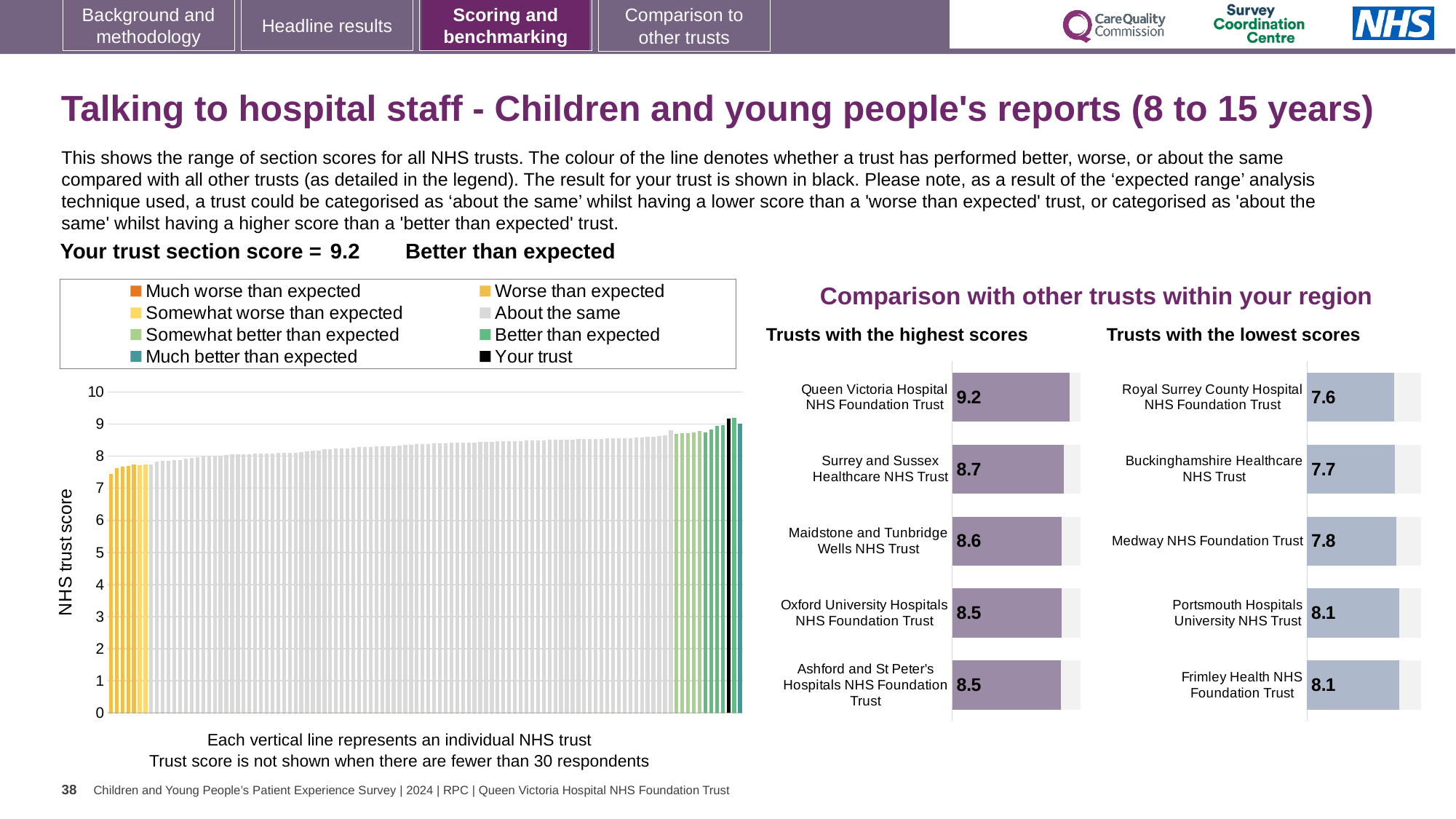
In the 'Trusts with the lowest scores' chart, which has the higher score: Buckinghamshire Healthcare NHS Trust or Portsmouth Hospitals University NHS Trust? Portsmouth Hospitals University NHS Trust In the 'Trusts with the lowest scores' chart, what is the score for Medway NHS Foundation Trust? 7.8 In the 'Trusts with the highest scores' chart, what is the difference between the scores of Queen Victoria Hospital NHS Foundation Trust and Maidstone and Tunbridge Wells NHS Trust? 0.6 In the 'Trusts with the lowest scores' chart, what is the score for Frimley Health NHS Foundation Trust? 8.1 What kind of chart is the large chart on the left showing all NHS trusts? Bar chart In the 'Trusts with the lowest scores' chart, what is the difference between the scores of Portsmouth Hospitals University NHS Trust and Royal Surrey County Hospital NHS Foundation Trust? 0.5 In the 'Trusts with the highest scores' chart, which trust has the highest score? Queen Victoria Hospital NHS Foundation Trust In the 'Trusts with the lowest scores' chart, which trust has the lowest score? Royal Surrey County Hospital NHS Foundation Trust How many entries does the legend above the large chart on the left list? 8 In the large chart on the left, do the trust scores rise or fall from left to right? Rise In the 'Trusts with the highest scores' chart, what is the score for Surrey and Sussex Healthcare NHS Trust? 8.7 How many trusts are shown in the 'Trusts with the highest scores' chart? 5